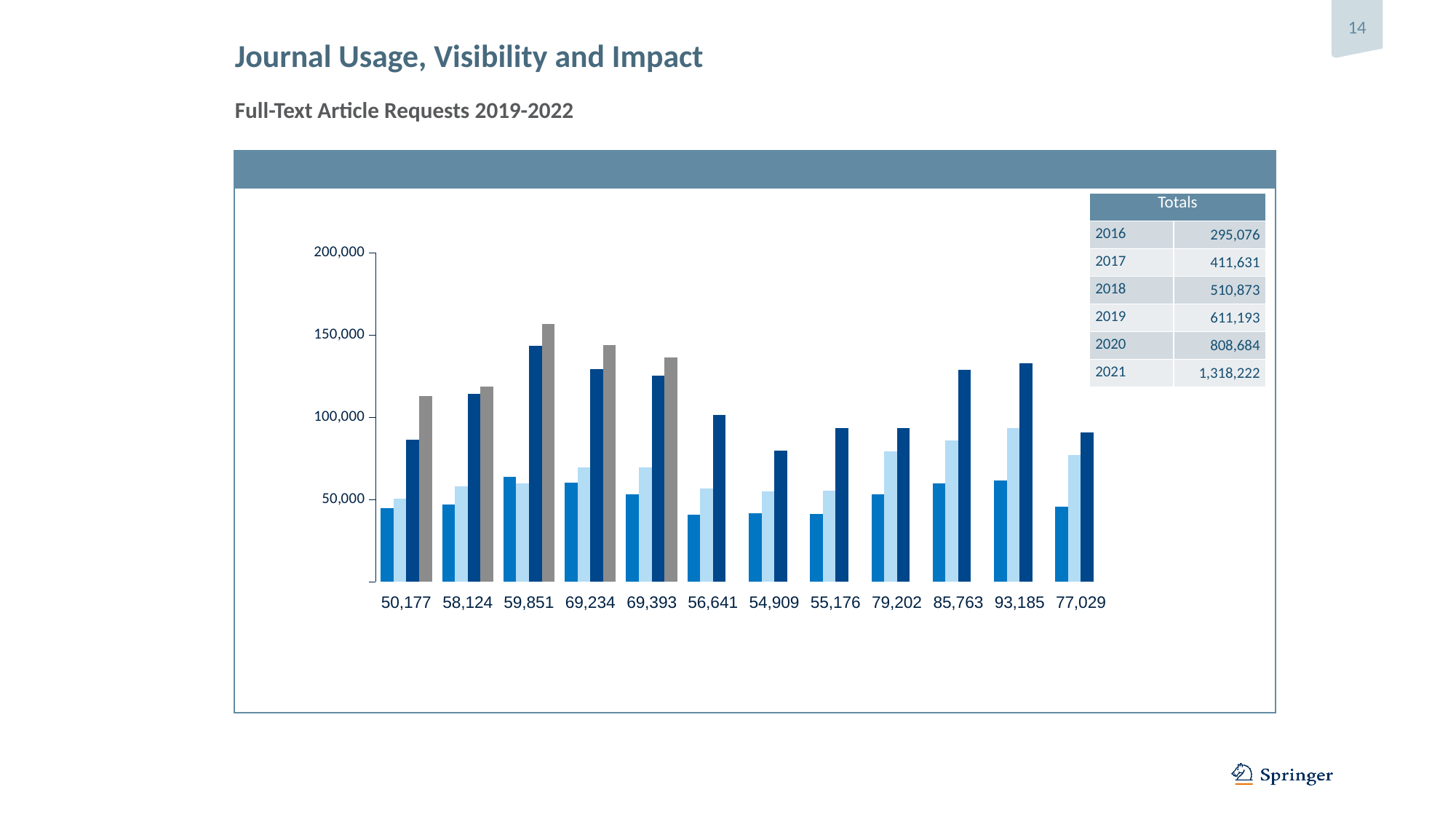
What is the highest value shown on the chart's vertical axis? 200,000 In the Totals table on the chart, what is the total for 2021? 1,318,222 Is the grey bar in the group labelled 59,851 greater or less than 150,000? greater What kind of chart is shown on the slide? bar chart Is the first (leftmost) bar in the group labelled 50,177 greater or less than 50,000? less In the Totals table on the chart, which year has the lowest total? 2016 How many groups of bars are plotted along the x axis of the chart? 12 Which x-axis label on the chart has the smallest value? 50,177 How many bars are in the group labelled 50,177? 4 Is the tallest bar in the group labelled 93,185 greater or less than 100,000? greater In the Totals table on the chart, what is the total for 2019? 611,193 Which x-axis label on the chart has the largest value? 93,185